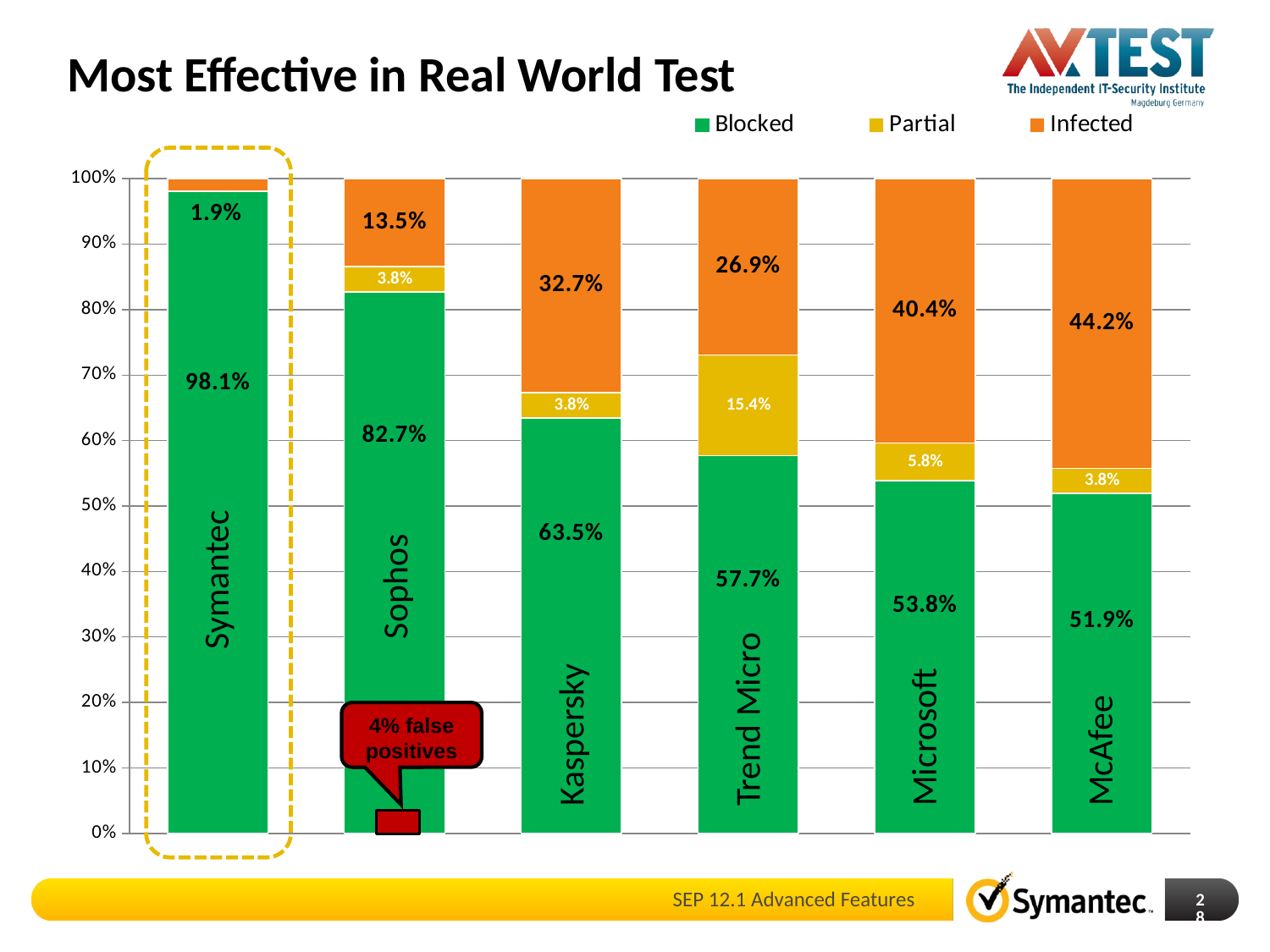
What is the difference between the Blocked values for Symantec and Sophos? 15.4% How many series does the legend list? 3 Which has a larger Infected value, Microsoft or Kaspersky? Microsoft What is the Partial value for Trend Micro? 15.4% What is the Infected value for Sophos? 13.5% What kind of chart is shown on the slide? Stacked bar chart How many vendors are shown on the chart? 6 Which vendor has the highest Partial value? Trend Micro What is the Blocked value for Symantec? 98.1% What is the Infected value for McAfee? 44.2% Which vendor has the highest Blocked value? Symantec Which vendor has the lowest Blocked value? McAfee